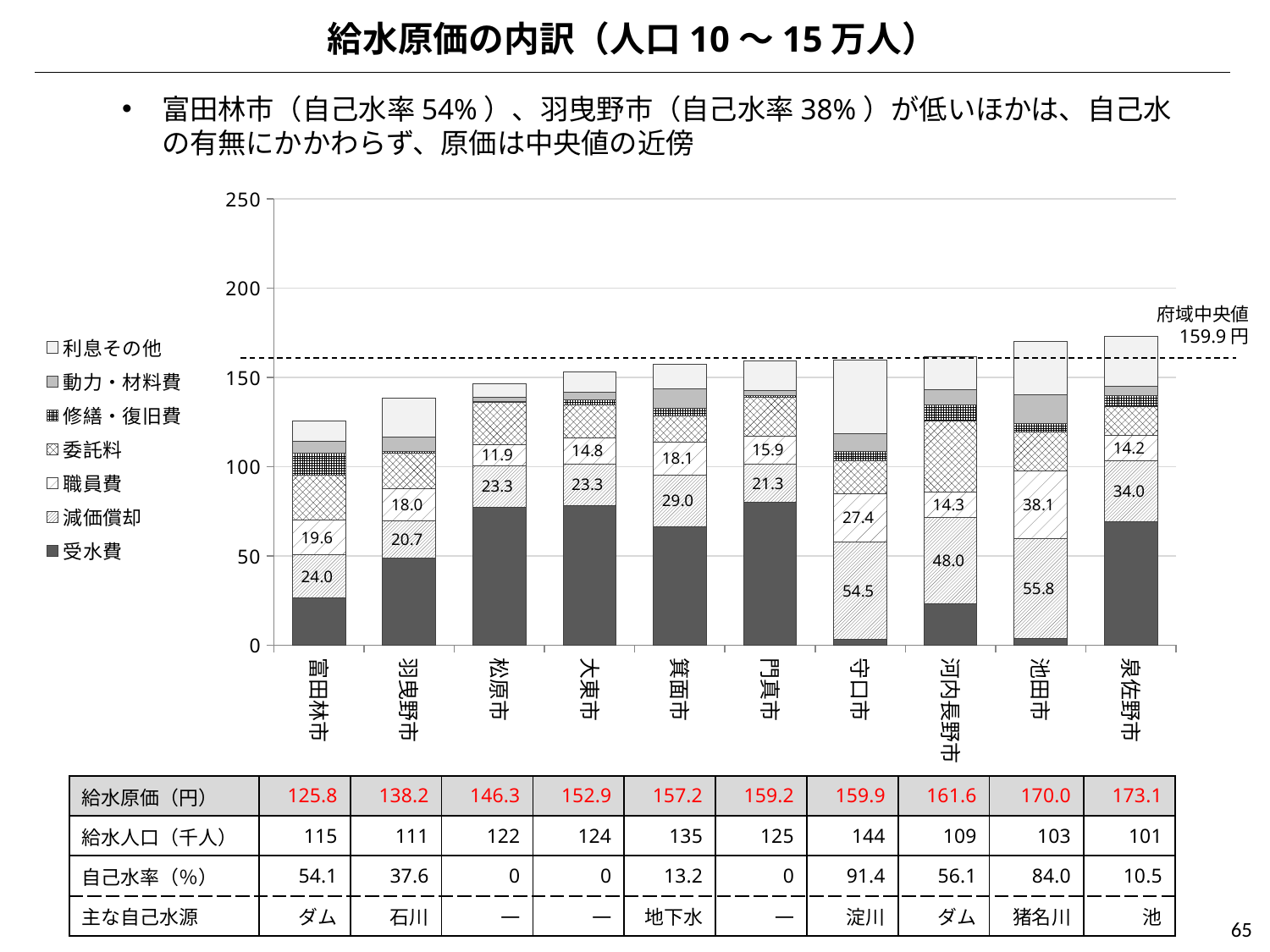
What is the difference between the 減価償却 values of 池田市 and 守口市? 1.3 How many series does the chart legend list? 7 What value does the dashed 府域中央値 line on the chart represent? 159.9円 What kind of chart is shown on the slide? Stacked bar chart What is the 職員費 value for 守口市? 27.4 What is the 減価償却 value for 池田市? 55.8 Which city has the larger 委託料 value, 箕面市 or 松原市? 松原市 Is the 受水費 value for 松原市 greater or less than 50? greater Which city has the highest total 給水原価 bar? 泉佐野市 Which city has the lowest total 給水原価 bar? 富田林市 How many cities are plotted along the x axis of the chart? 10